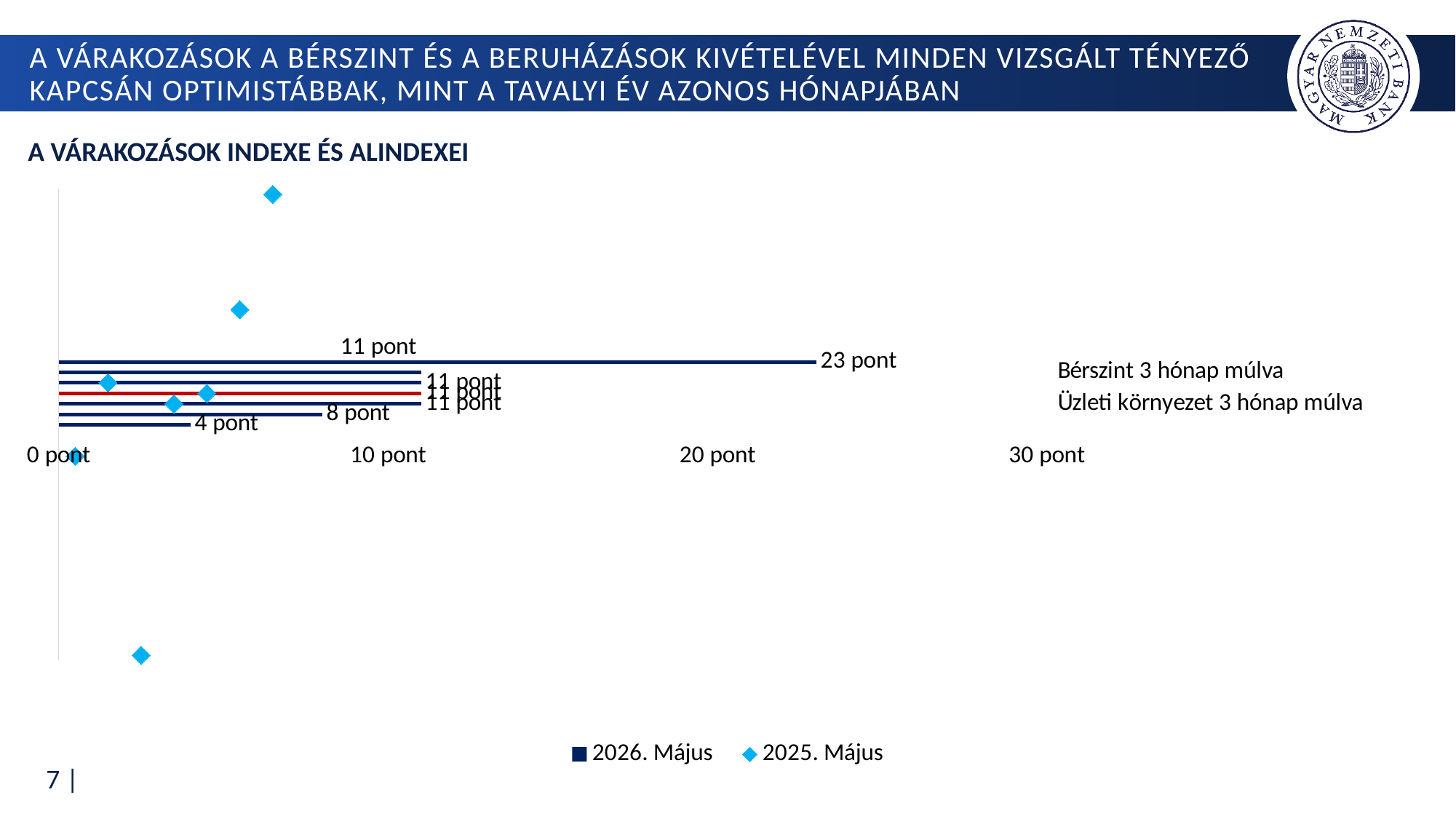
What is the difference between the bar labelled 23 pont and the bar labelled 8 pont? 15 pont Is the shortest 2026. Május bar greater or less than 10 pont? less What is the lowest value labelled on a 2026. Május bar? 4 pont What is the difference between the highest labelled bar value (23 pont) and the lowest labelled bar value (4 pont)? 19 pont What kind of chart is shown on the slide? bar chart What are the two series named in the legend? 2026. Május and 2025. Május What is the title of the chart? A VÁRAKOZÁSOK INDEXE ÉS ALINDEXEI How many bars are labelled 11 pont? 4 What is the highest value labelled on a 2026. Május bar? 23 pont Is the longest 2026. Május bar greater or less than 20 pont? greater How many 2026. Május bars are plotted on the chart? 7 How many series does the chart legend list? 2